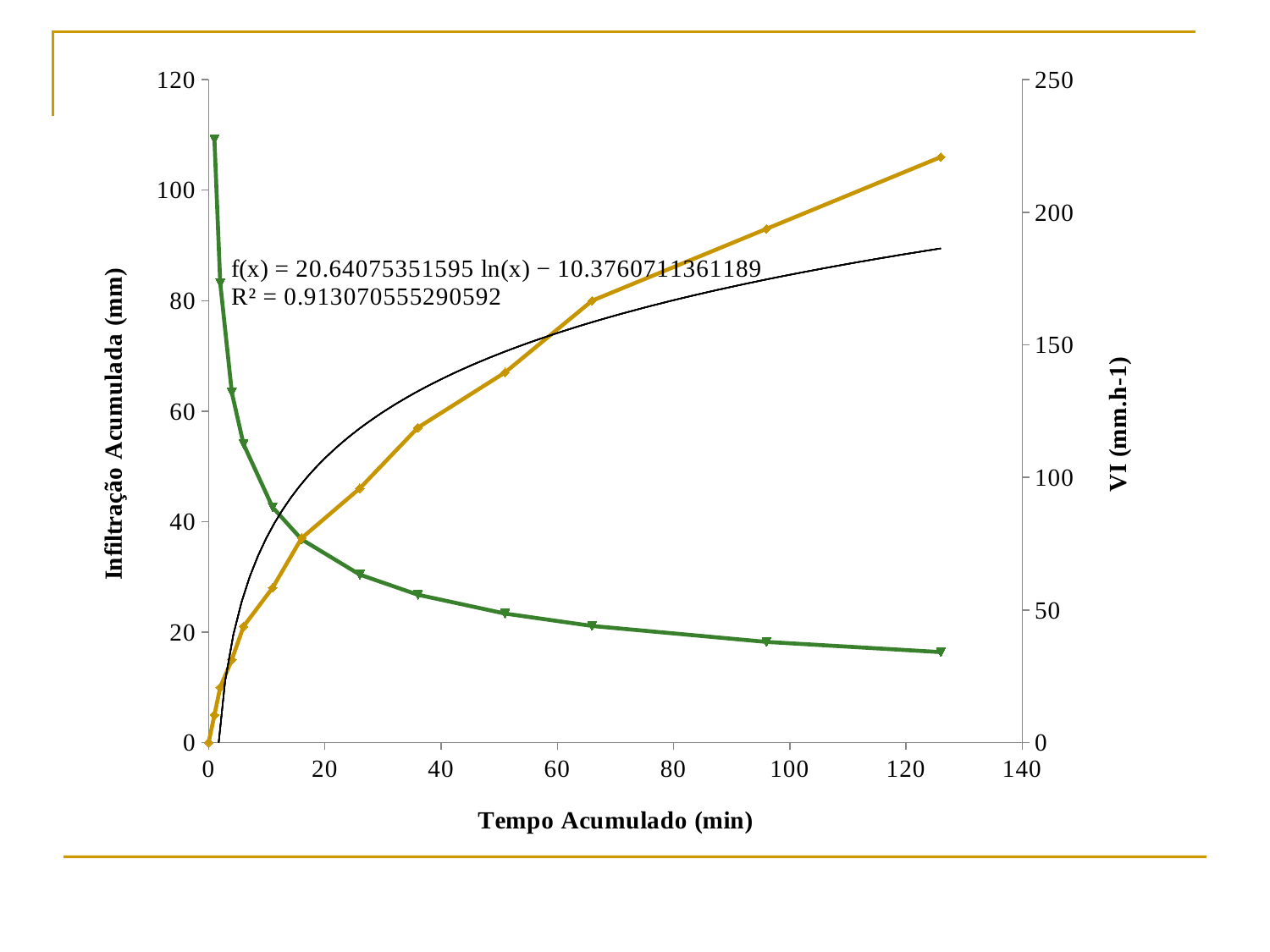
What kind of chart is shown on the slide? line chart Is the Infiltração Acumulada value at about 16 min greater or less than 60 mm? less Is the Infiltração Acumulada value at about 96 min greater or less than 80 mm? greater Does the VI (mm.h-1) series rise or fall as Tempo Acumulado increases? fall Is the VI value at the last point (about 126 min) greater or less than 50 mm.h-1? less Does the Infiltração Acumulada (mm) series rise or fall as Tempo Acumulado increases? rise What is the title of the x axis of the chart? Tempo Acumulado (min) What is the R² value printed on the chart for the fitted trendline? 0.913070555290592